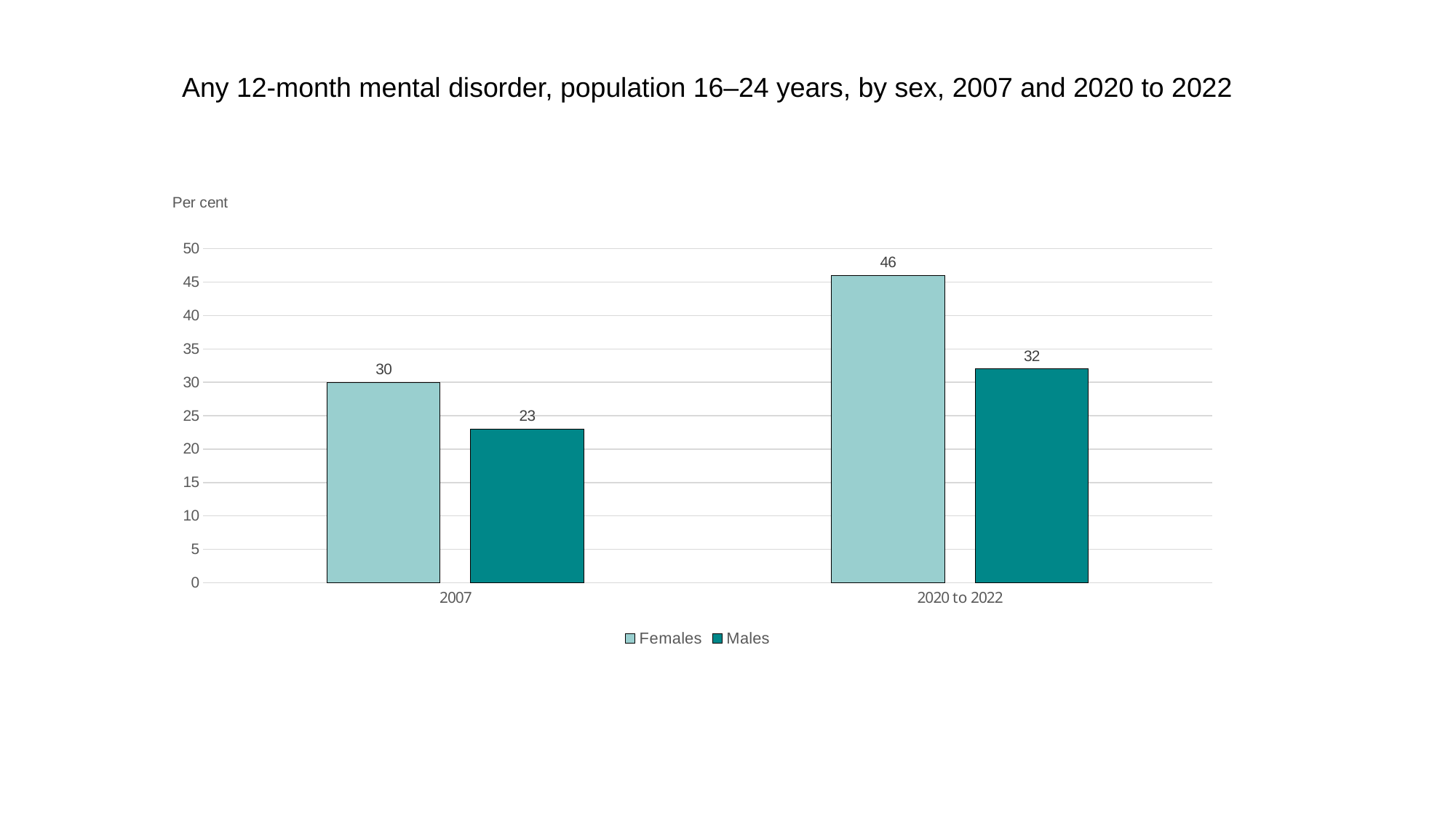
What is the value for Males in 2020 to 2022? 32 How many categories are shown on the x axis? 2 Which is larger, the Males value in 2020 to 2022 or the Females value in 2007? Males in 2020 to 2022 Which bar has the lowest value on the chart? Males in 2007 What is the value for Females in 2007? 30 What is the value for Males in 2007? 23 What is the difference between the Females value in 2020 to 2022 and the Females value in 2007? 16 What is the difference between Females and Males in 2007? 7 Do the Males values rise or fall from 2007 to 2020 to 2022? Rise What kind of chart is shown on the slide? Bar chart Which series has the highest value in 2020 to 2022? Females How many series does the legend list? 2